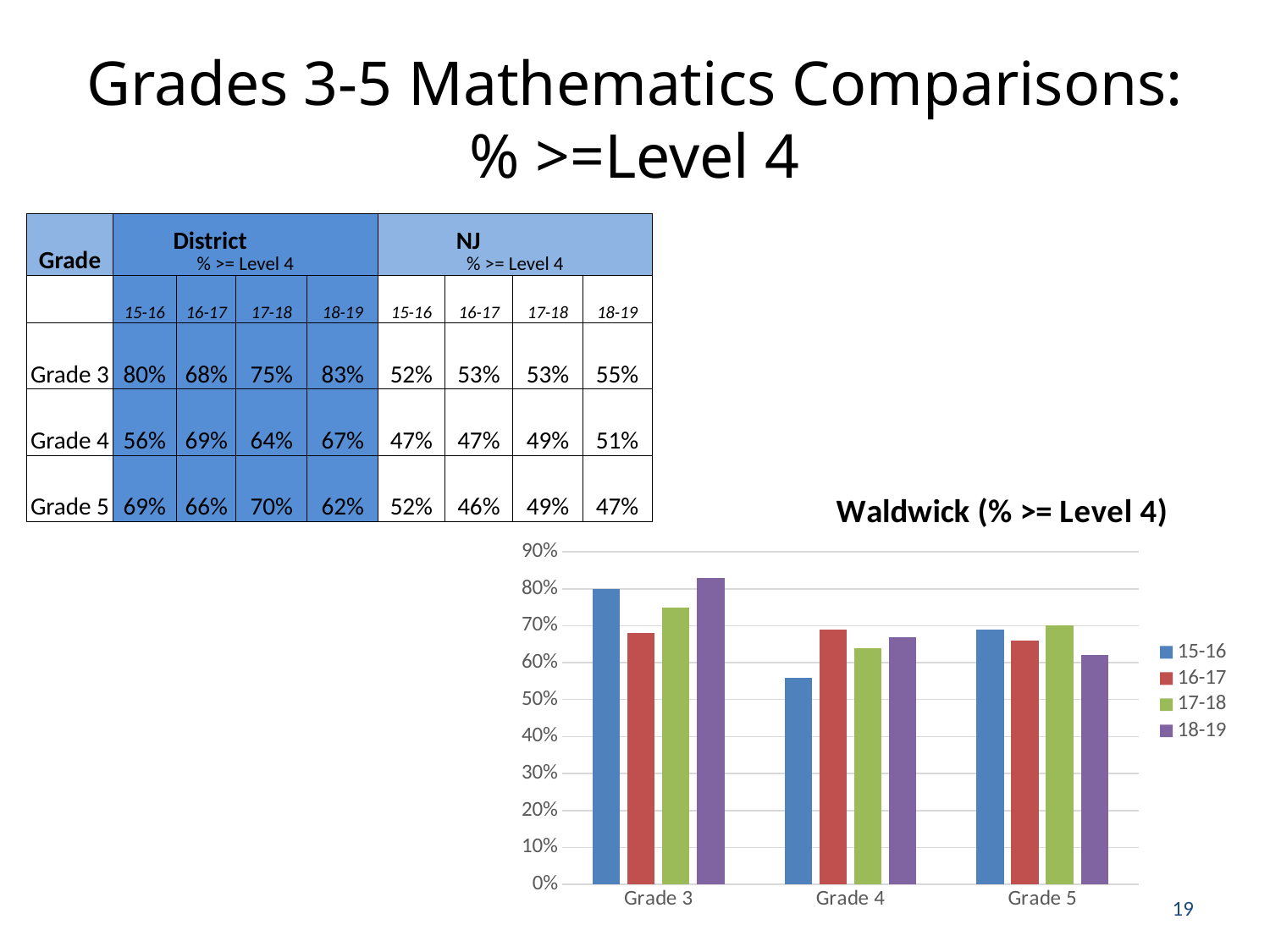
What type of chart is shown on the slide? bar chart In the Waldwick (% >= Level 4) chart, what is the value for Grade 5 in 17-18? 70% In the Waldwick (% >= Level 4) chart, do the Grade 3 values rise or fall from 16-17 through 18-19? rise How many series does the legend of the Waldwick (% >= Level 4) chart list? 4 In the Waldwick (% >= Level 4) chart, which school year has the lowest bar for Grade 4? 15-16 In the Waldwick (% >= Level 4) chart, is the value for Grade 4 in 15-16 greater or less than 60%? less In the Waldwick (% >= Level 4) chart, which school year has the highest bar for Grade 3? 18-19 What is the title of the chart on the slide? Waldwick (% >= Level 4) How many grade categories are shown on the x axis of the Waldwick (% >= Level 4) chart? 3 In the Waldwick (% >= Level 4) chart, which is larger for Grade 5: the 17-18 bar or the 18-19 bar? 17-18 In the Waldwick (% >= Level 4) chart, what is the value for Grade 3 in 15-16? 80% In the Waldwick (% >= Level 4) chart, is the value for Grade 3 in 18-19 greater or less than 80%? greater